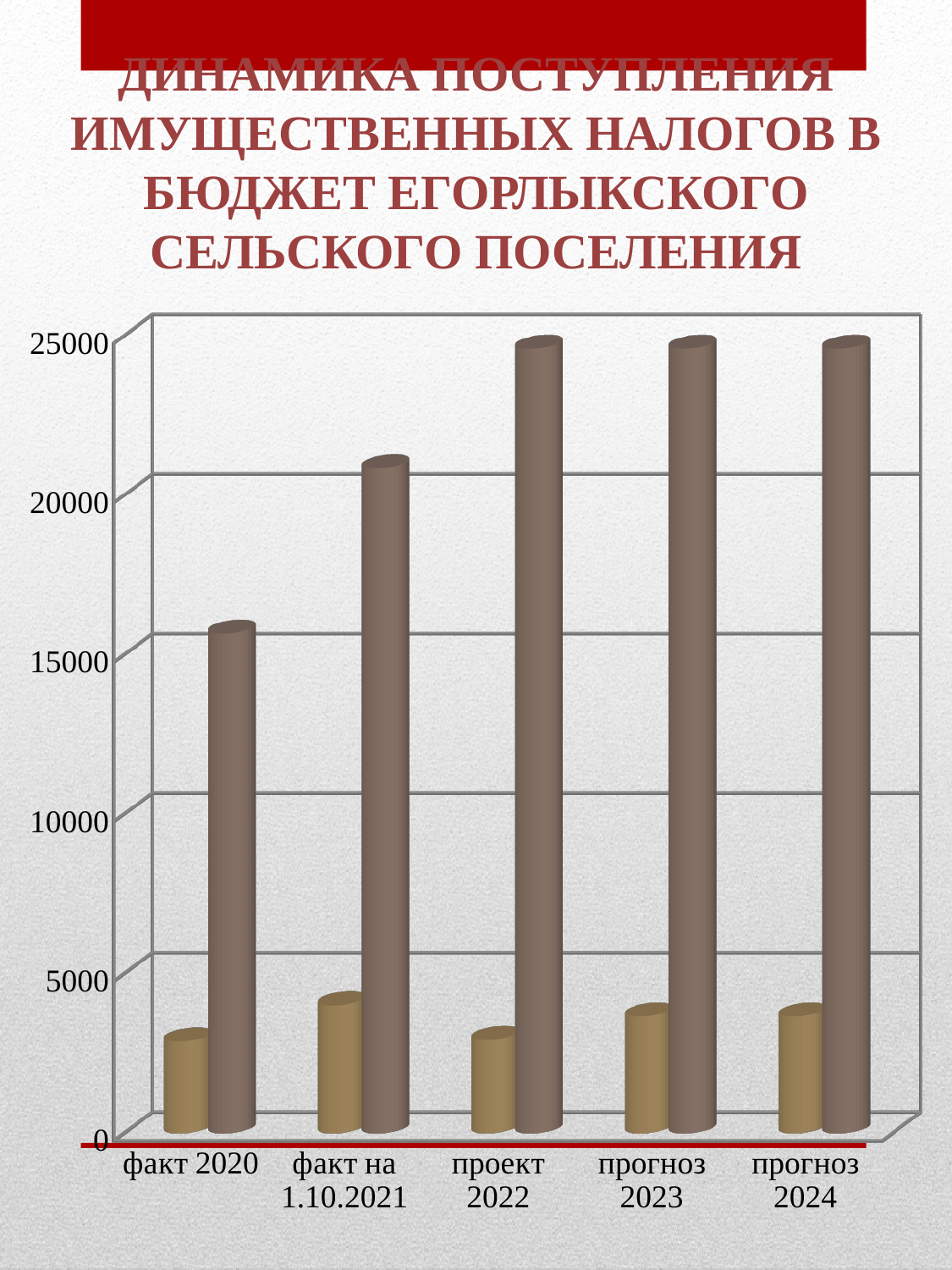
Which category has the lowest value for the taller (brown) bars? факт 2020 Which is larger for the taller (brown) bars: факт 2020 or факт на 1.10.2021? факт на 1.10.2021 Is the value of the taller (brown) bar for факт 2020 greater or less than 20000? less Is the value of the taller (brown) bar for факт на 1.10.2021 greater or less than 15000? greater Which is larger for the shorter (gold) bars: факт 2020 or факт на 1.10.2021? факт на 1.10.2021 Do the taller (brown) bars rise or fall from факт 2020 to проект 2022? rise Is the value of the taller (brown) bar for проект 2022 greater or less than 20000? greater How many categories are shown along the x axis of the chart? 5 What kind of chart is shown on the slide? bar chart How many bars are plotted for each category on the chart? 2 What is the title of the slide containing the chart? ДИНАМИКА ПОСТУПЛЕНИЯ ИМУЩЕСТВЕННЫХ НАЛОГОВ В БЮДЖЕТ ЕГОРЛЫКСКОГО СЕЛЬСКОГО ПОСЕЛЕНИЯ